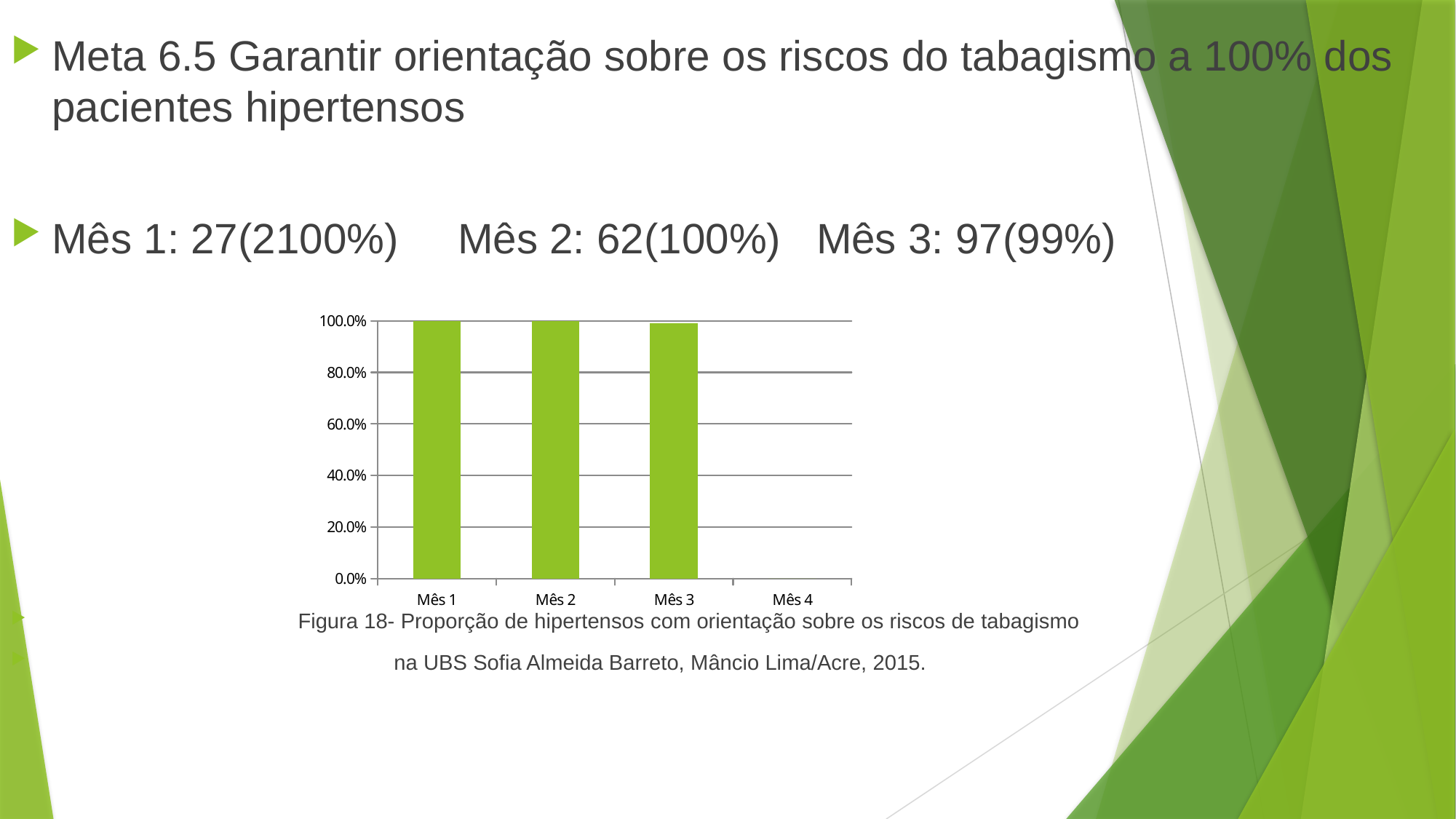
Which category has the lowest value in the chart? Mês 4 Which is larger, the value for Mês 1 or the value for Mês 4? Mês 1 What is the highest value shown on the y axis of the chart? 100.0% Is the value for Mês 3 greater or less than 80.0%? greater What is the value for Mês 2 in the chart? 100.0% What kind of chart is shown on the slide? bar chart How many categories are shown on the x axis of the chart? 4 Is the value for Mês 3 greater or less than 60.0%? greater What is the value for Mês 1 in the chart? 100.0% Which is larger, the value for Mês 2 or the value for Mês 4? Mês 2 What figure number is given in the caption below the chart? Figura 18